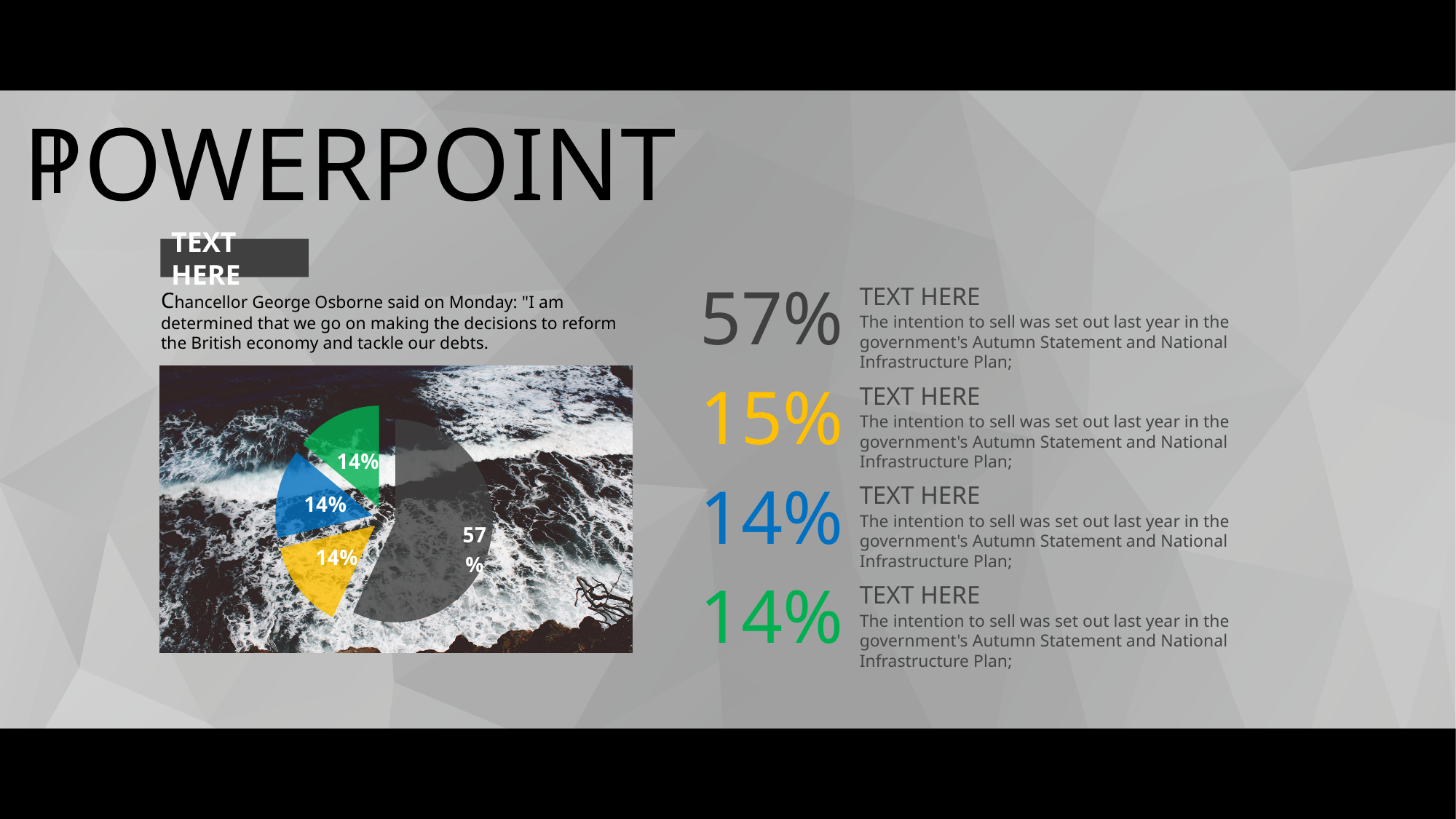
How many slices of the pie chart are labelled 14%? 3 Which slice of the pie chart is the largest? the dark grey slice (57%) How many slices does the pie chart have? 4 What percentage is shown on the blue slice of the pie chart? 14% What percentage is shown on the dark grey slice of the pie chart? 57% Is the dark grey slice of the pie chart greater or less than 50%? greater What kind of chart is shown on the slide? pie chart What percentage is shown on the green slice of the pie chart? 14% Which is larger in the pie chart, the dark grey slice or the green slice? the dark grey slice What percentage is shown on the yellow slice of the pie chart? 14% What is the difference between the dark grey slice and the blue slice in the pie chart? 43% What colour is the largest slice of the pie chart? dark grey